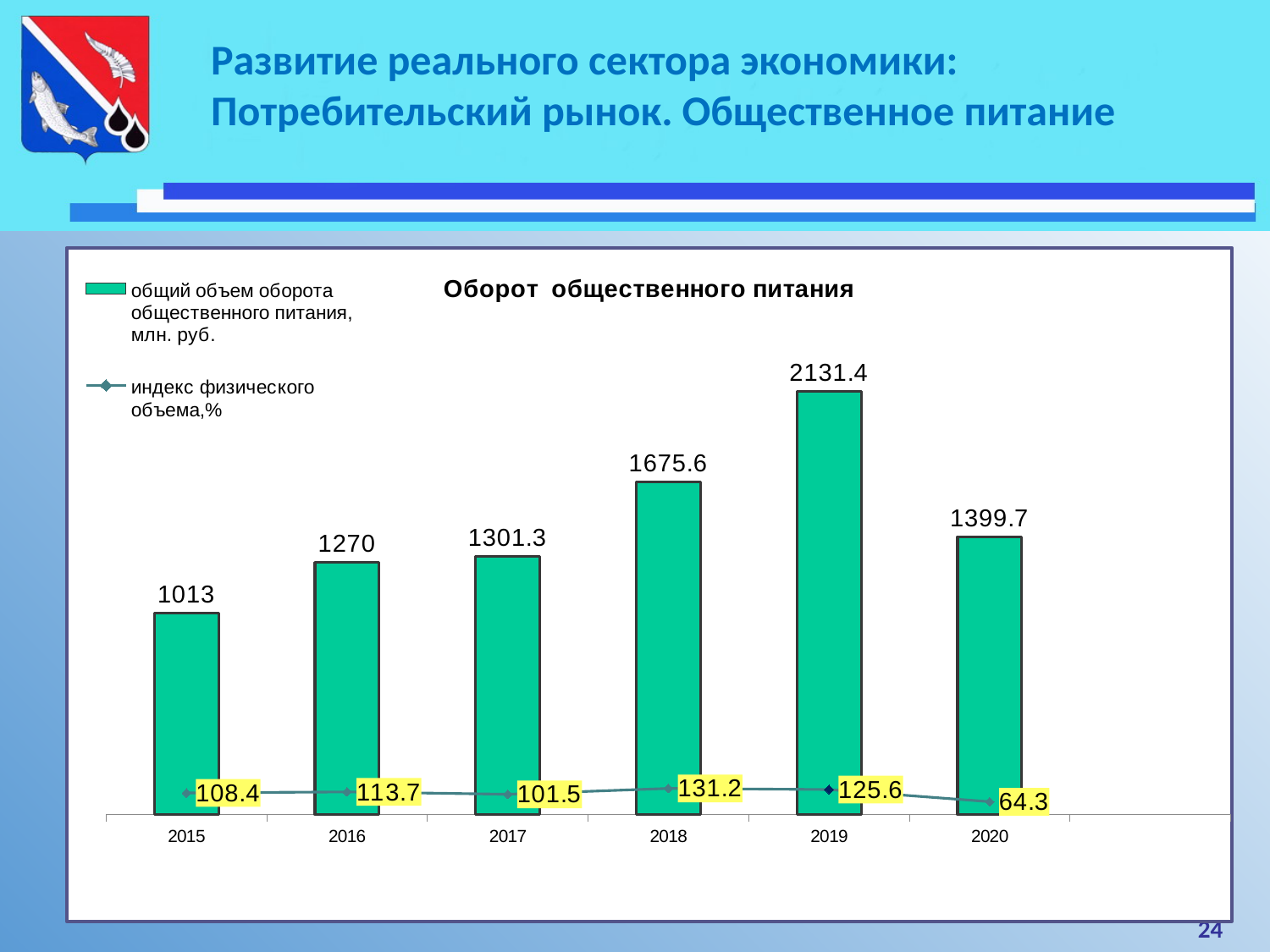
How many years are shown on the x axis of the chart? 6 What is the title of the chart? Оборот общественного питания What is the physical volume index (%) for 2018? 131.2 Which year has a larger public catering turnover, 2016 or 2018? 2018 By how much did the public catering turnover (млн. руб.) change from 2019 to 2020? 731.7 How many series does the legend list? 2 What is the public catering turnover (млн. руб.) shown for 2015? 1013 In which year is the public catering turnover (млн. руб.) the highest? 2019 In which year is the physical volume index (%) the lowest? 2020 What is the total volume of public catering turnover (общий объем оборота общественного питания, млн. руб.) in 2019? 2131.4 What is the value of the physical volume index (индекс физического объема, %) in 2020? 64.3 What is the difference between the physical volume index in 2018 and in 2017? 29.7